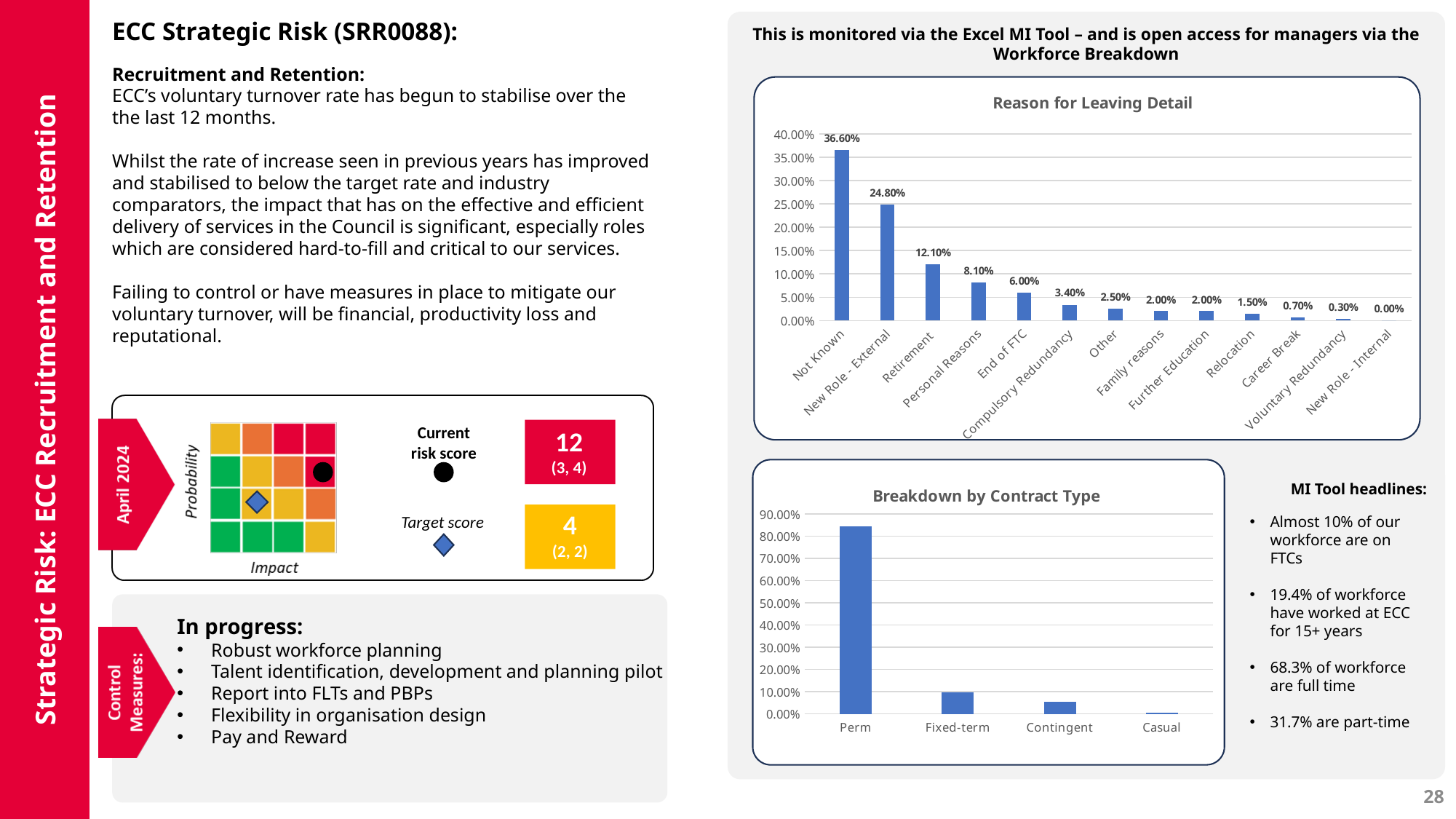
What kind of chart is 'Breakdown by Contract Type'? bar chart In the 'Breakdown by Contract Type' chart, is the value for Perm greater or less than 80.00%? greater In the 'Reason for Leaving Detail' chart, what is the value for End of FTC? 6.00% In the 'Breakdown by Contract Type' chart, is the value for Fixed-term greater or less than 20.00%? less In the 'Reason for Leaving Detail' chart, do the values rise or fall from left to right? fall In the 'Reason for Leaving Detail' chart, which is larger: Personal Reasons or Compulsory Redundancy? Personal Reasons In the 'Reason for Leaving Detail' chart, what is the difference between Not Known and New Role - External? 11.80% In the 'Reason for Leaving Detail' chart, which reason has the lowest value? New Role - Internal In the 'Reason for Leaving Detail' chart, which reason has the highest value? Not Known In the 'Breakdown by Contract Type' chart, which contract type has the highest value? Perm In the 'Reason for Leaving Detail' chart, what is the value for Retirement? 12.10% How many reasons are shown in the 'Reason for Leaving Detail' chart? 13